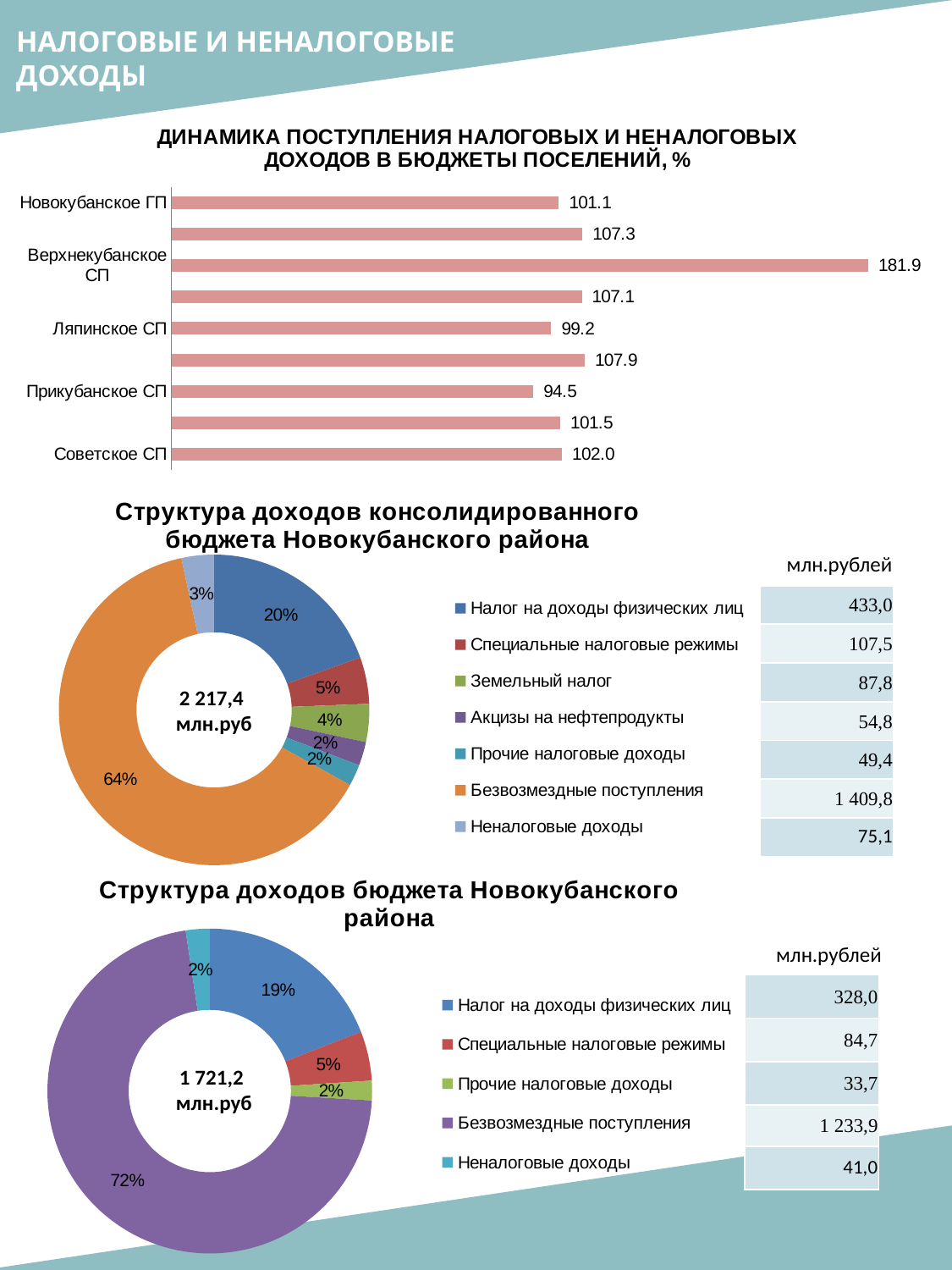
In the bar chart 'Динамика поступления налоговых и неналоговых доходов в бюджеты поселений, %', which labelled settlement has the highest value? Верхнекубанское СП In the bar chart 'Динамика поступления налоговых и неналоговых доходов в бюджеты поселений, %', which labelled settlement has the lowest value? Прикубанское СП In the bar chart 'Динамика поступления налоговых и неналоговых доходов в бюджеты поселений, %', what is the difference between the values for Советское СП and Новокубанское ГП? 0.9 How many categories does the legend of 'Структура доходов консолидированного бюджета Новокубанского района' list? 7 In the chart 'Структура доходов консолидированного бюджета Новокубанского района', what share do Безвозмездные поступления have? 64% In the chart 'Структура доходов бюджета Новокубанского района', what is the value in млн.рублей for Безвозмездные поступления? 1 233,9 In the bar chart 'Динамика поступления налоговых и неналоговых доходов в бюджеты поселений, %', how many bars are plotted? 9 In the chart 'Структура доходов бюджета Новокубанского района', which is larger: Специальные налоговые режимы or Неналоговые доходы? Специальные налоговые режимы In the bar chart 'Динамика поступления налоговых и неналоговых доходов в бюджеты поселений, %', what is the value for Прикубанское СП? 94.5 In the chart 'Структура доходов консолидированного бюджета Новокубанского района', what is the value in млн.рублей for Налог на доходы физических лиц? 433,0 What type of chart is 'Динамика поступления налоговых и неналоговых доходов в бюджеты поселений, %'? Bar chart In the bar chart 'Динамика поступления налоговых и неналоговых доходов в бюджеты поселений, %', what is the value for Верхнекубанское СП? 181.9